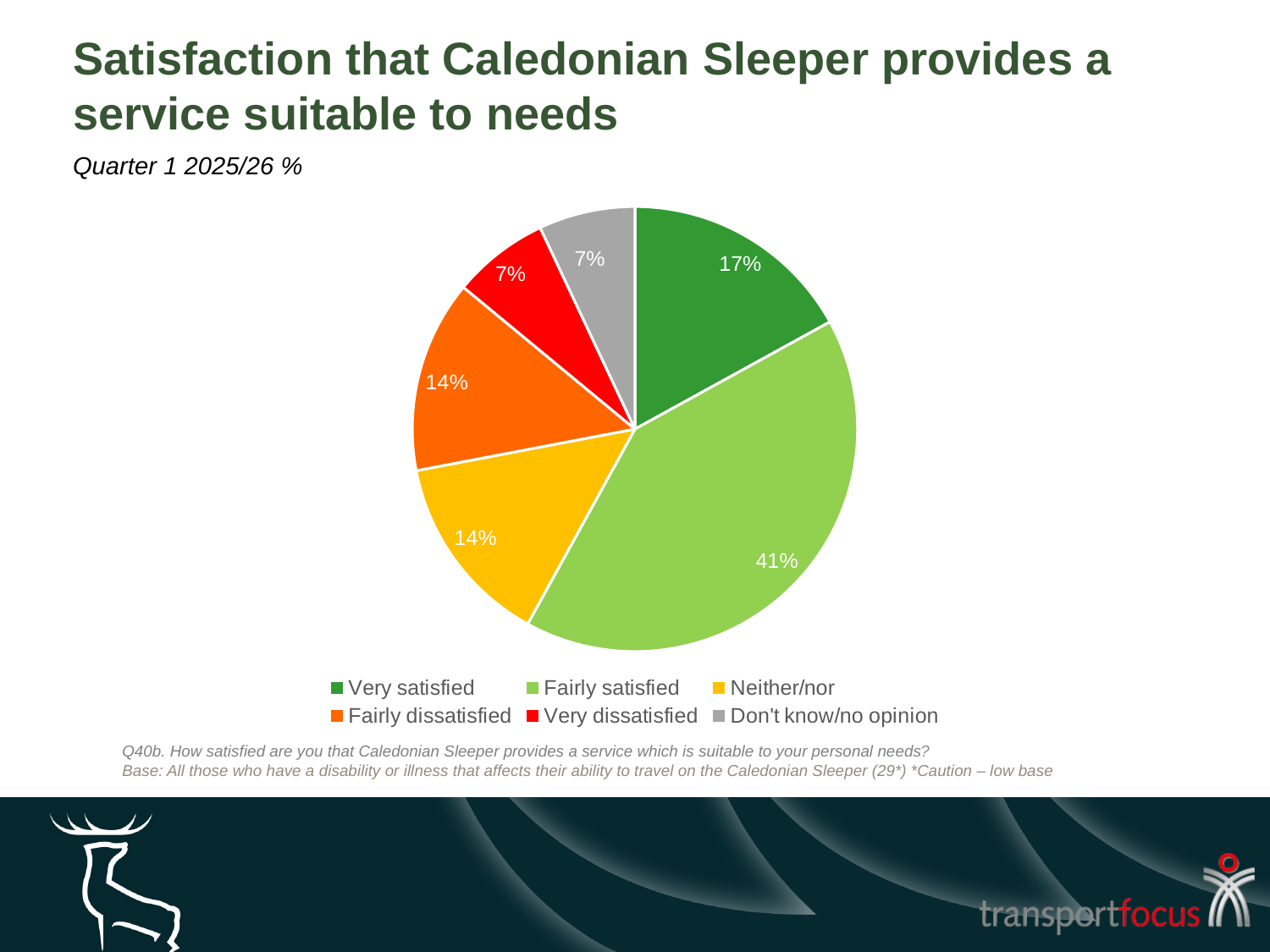
What is the difference in percentage points between fairly satisfied and very satisfied? 24 What percentage of respondents were fairly satisfied? 41% How many categories does the pie chart show? 6 What percentage of respondents answered neither/nor? 14% What percentage of respondents answered don't know/no opinion? 7% What percentage of respondents were very satisfied? 17% What is the combined percentage of very satisfied and fairly satisfied respondents? 58% What kind of chart is shown on the slide? Pie chart What percentage of respondents were very dissatisfied? 7% Which is larger, the share for very satisfied or the share for fairly dissatisfied? Very satisfied Which category has the largest share of the pie? Fairly satisfied What colour is the fairly satisfied slice? Light green